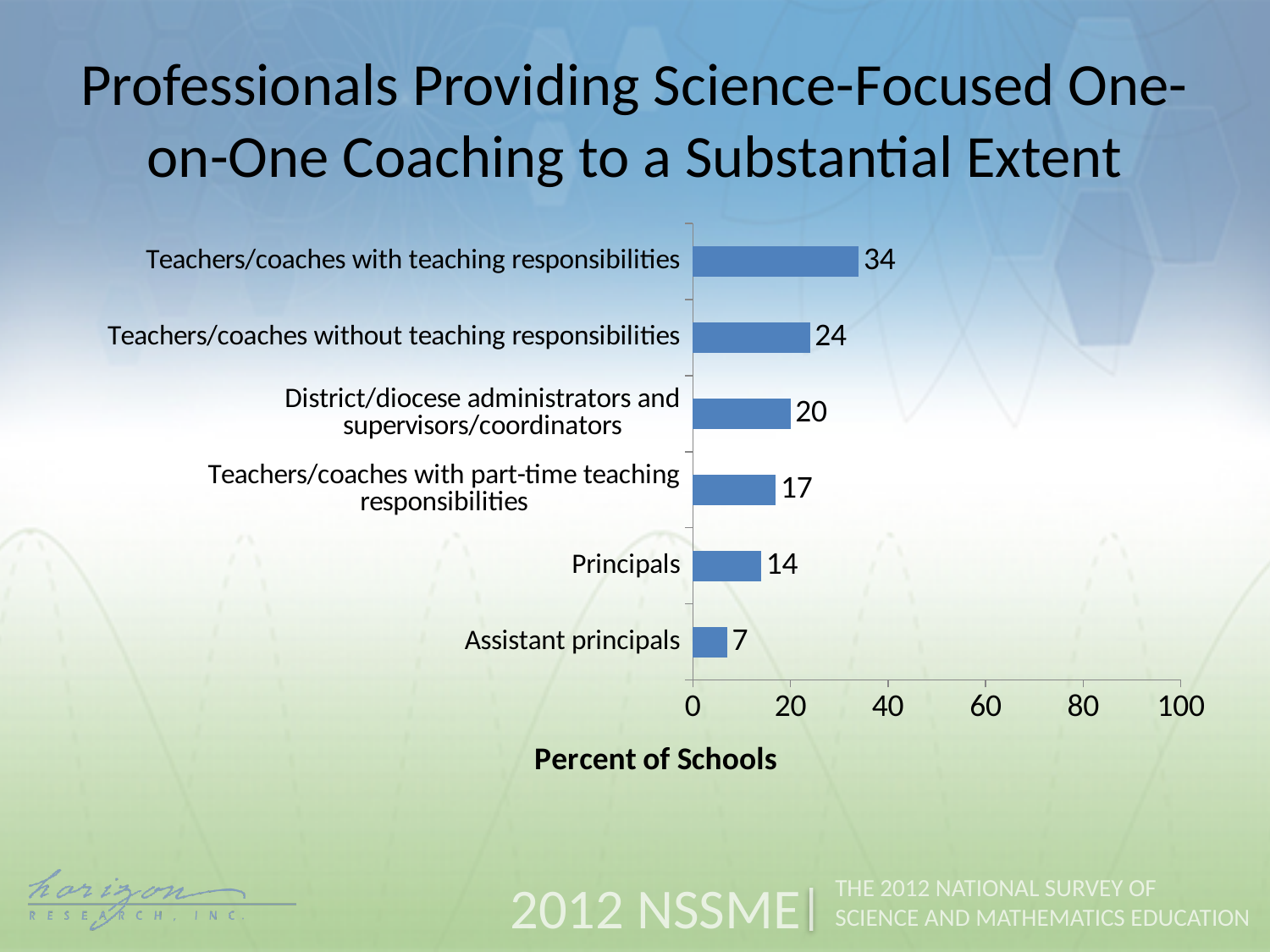
What is the label of the horizontal axis? Percent of Schools What is the value for Assistant principals? 7 What is the difference between the values for Teachers/coaches with teaching responsibilities and Teachers/coaches without teaching responsibilities? 10 What percent of schools have teachers/coaches with teaching responsibilities providing science-focused one-on-one coaching to a substantial extent? 34 Is the value for Teachers/coaches without teaching responsibilities greater or less than 40? less How many categories are shown in the chart? 6 What is the value for Principals? 14 What is the value for District/diocese administrators and supervisors/coordinators? 20 Which category has the highest percent of schools? Teachers/coaches with teaching responsibilities Which category has the lowest percent of schools? Assistant principals What kind of chart is shown on the slide? Bar chart Which is larger: the value for Principals or the value for Teachers/coaches with part-time teaching responsibilities? Teachers/coaches with part-time teaching responsibilities